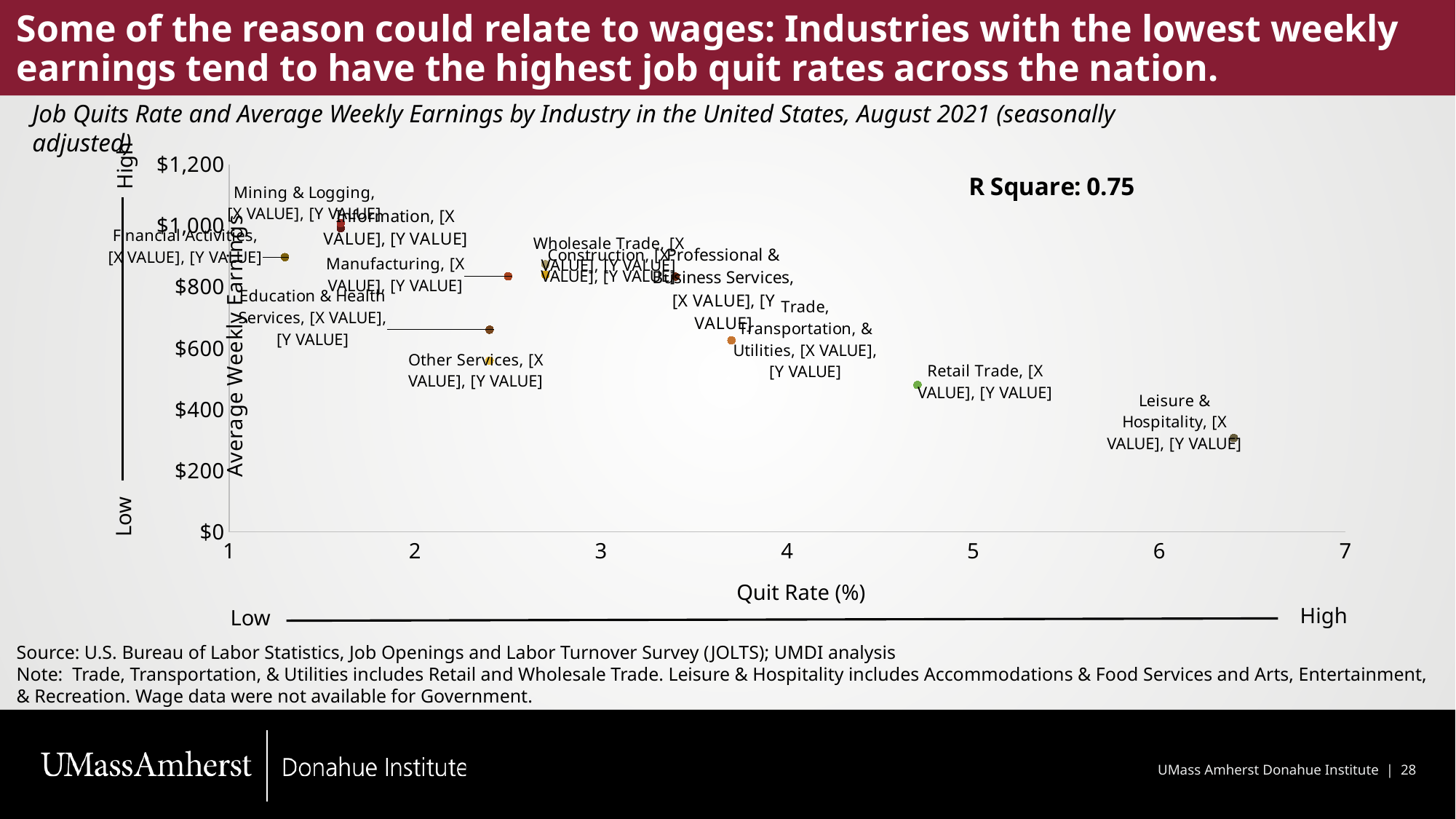
Is the quit rate for Retail Trade greater or less than 4? greater Is the quit rate for Leisure & Hospitality greater or less than 6? greater Which industry has the lowest quit rate on the chart? Financial Activities What R Square value is shown on the chart? 0.75 How many industries are plotted on the chart? 12 Is the average weekly earnings value for Leisure & Hospitality greater or less than $400? less Which industry has the lowest average weekly earnings on the chart? Leisure & Hospitality Which has the higher quit rate, Retail Trade or Leisure & Hospitality? Leisure & Hospitality What kind of chart is shown on the slide? scatter chart As the quit rate increases along the x axis, do average weekly earnings generally rise or fall? fall Which industry has the highest quit rate on the chart? Leisure & Hospitality